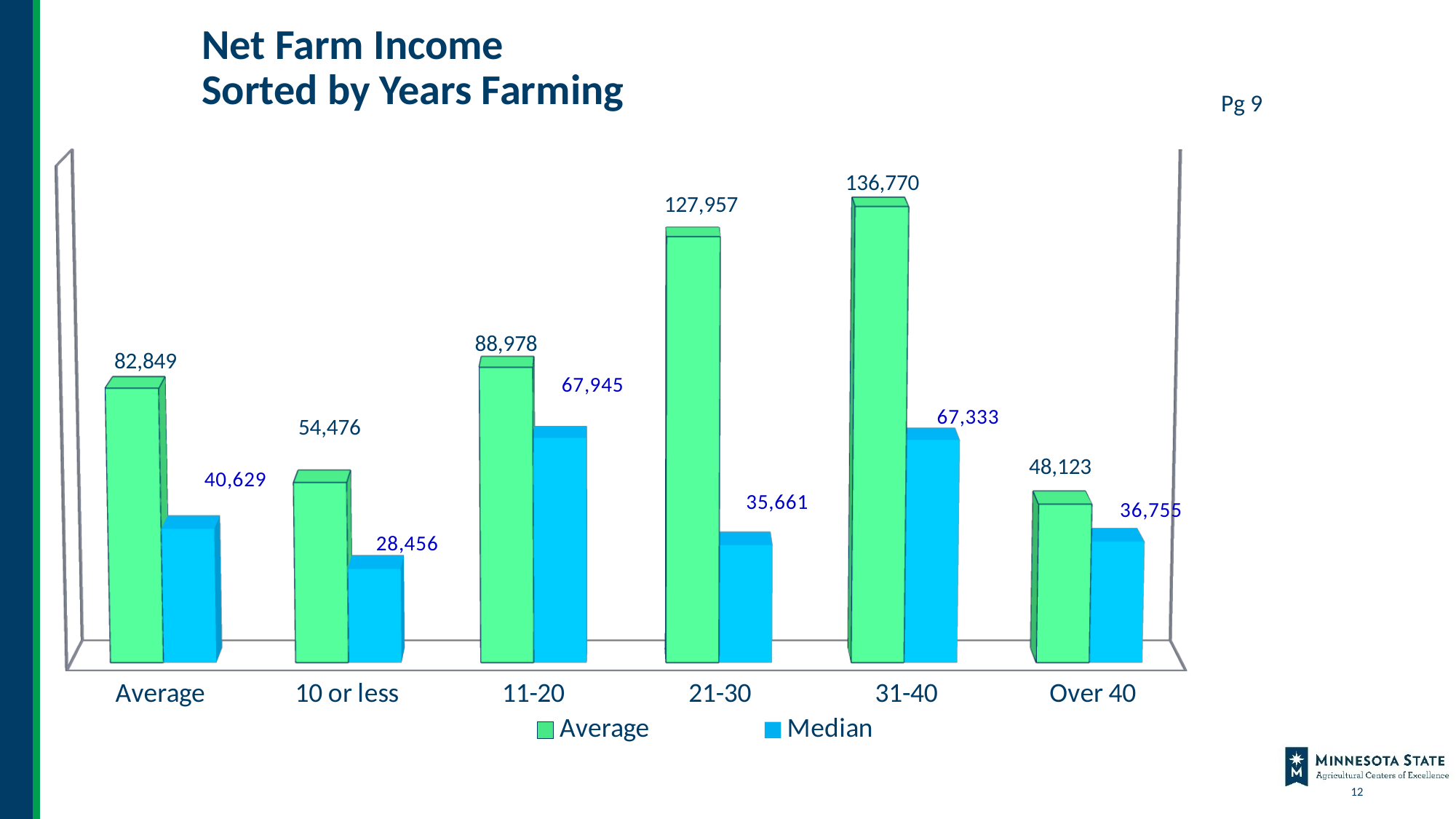
Which years-farming category has the highest Average net farm income? 31-40 Which years-farming category has the lowest Median net farm income? 10 or less What is the Median net farm income for the Over 40 years farming group? 36,755 What is the difference between the Average net farm income for 31-40 years and for 21-30 years? 8,813 What is the Average net farm income for farms with 10 or less years farming? 54,476 Which years-farming category has the lowest Average net farm income? Over 40 What type of chart is shown on the slide? Bar chart What is the difference between the Average and Median net farm income for the 11-20 years group? 21,033 How many series does the legend list? 2 How many categories are shown on the x axis? 6 Which is larger, the Median net farm income for 11-20 years or for 21-30 years? 11-20 years What is the Median net farm income for the 21-30 years farming group? 35,661